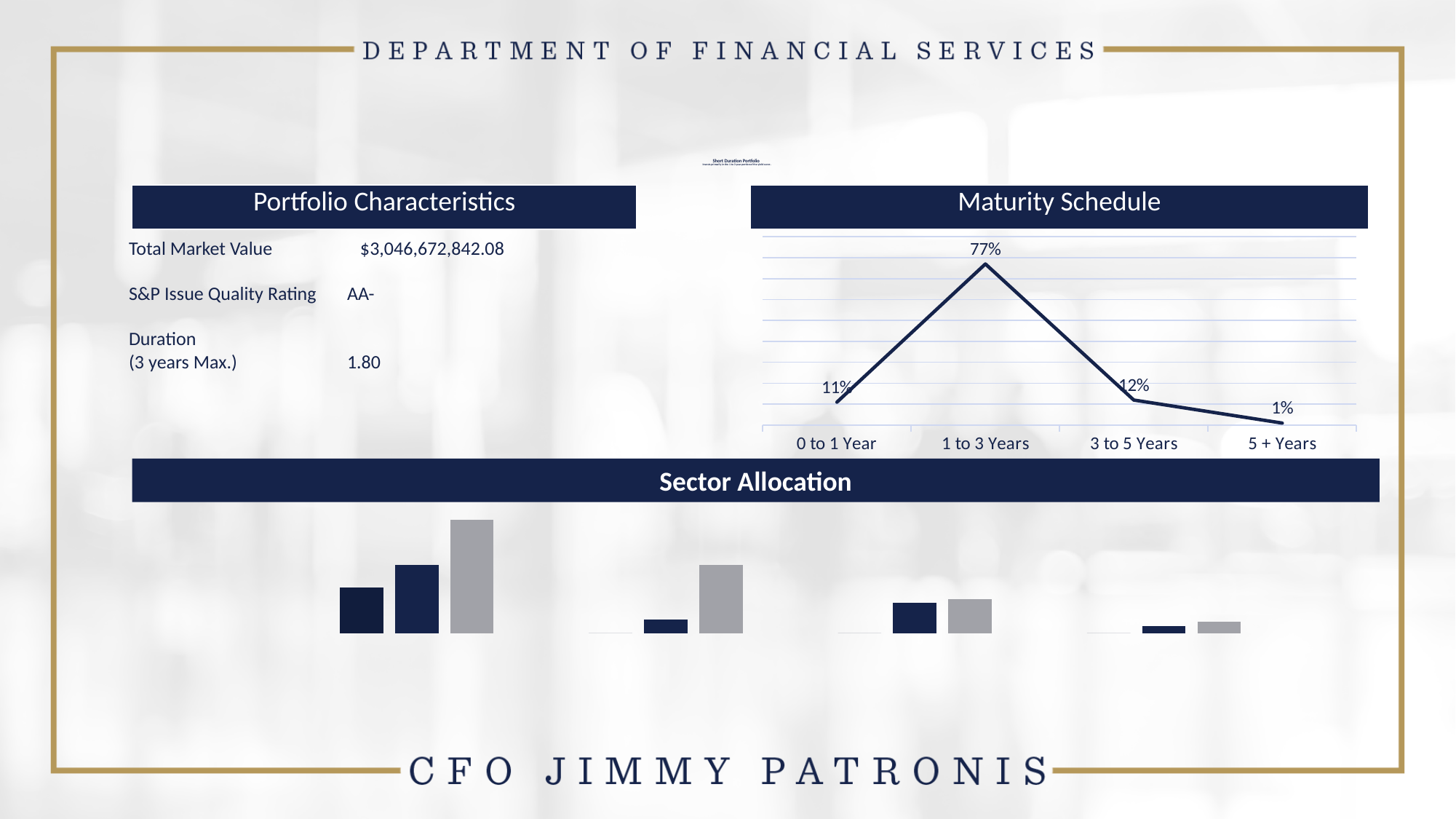
In the Maturity Schedule chart, what is the difference between the values for 3 to 5 Years and 5 + Years? 11% In the Maturity Schedule chart, what is the value for 0 to 1 Year? 11% In the Maturity Schedule chart, which maturity bucket has the lowest value? 5 + Years How many maturity buckets are shown on the x axis of the Maturity Schedule chart? 4 What kind of chart is the Maturity Schedule chart? Line chart In the Maturity Schedule chart, what is the value for 1 to 3 Years? 77% In the Maturity Schedule chart, which maturity bucket has the highest value? 1 to 3 Years In the Maturity Schedule chart, what is the difference between the values for 1 to 3 Years and 0 to 1 Year? 66% In the Maturity Schedule chart, what is the value for 3 to 5 Years? 12% What kind of chart is the Sector Allocation chart? Bar chart In the Maturity Schedule chart, what is the value for 5 + Years? 1% In the Maturity Schedule chart, which is larger, the value for 0 to 1 Year or the value for 1 to 3 Years? 1 to 3 Years